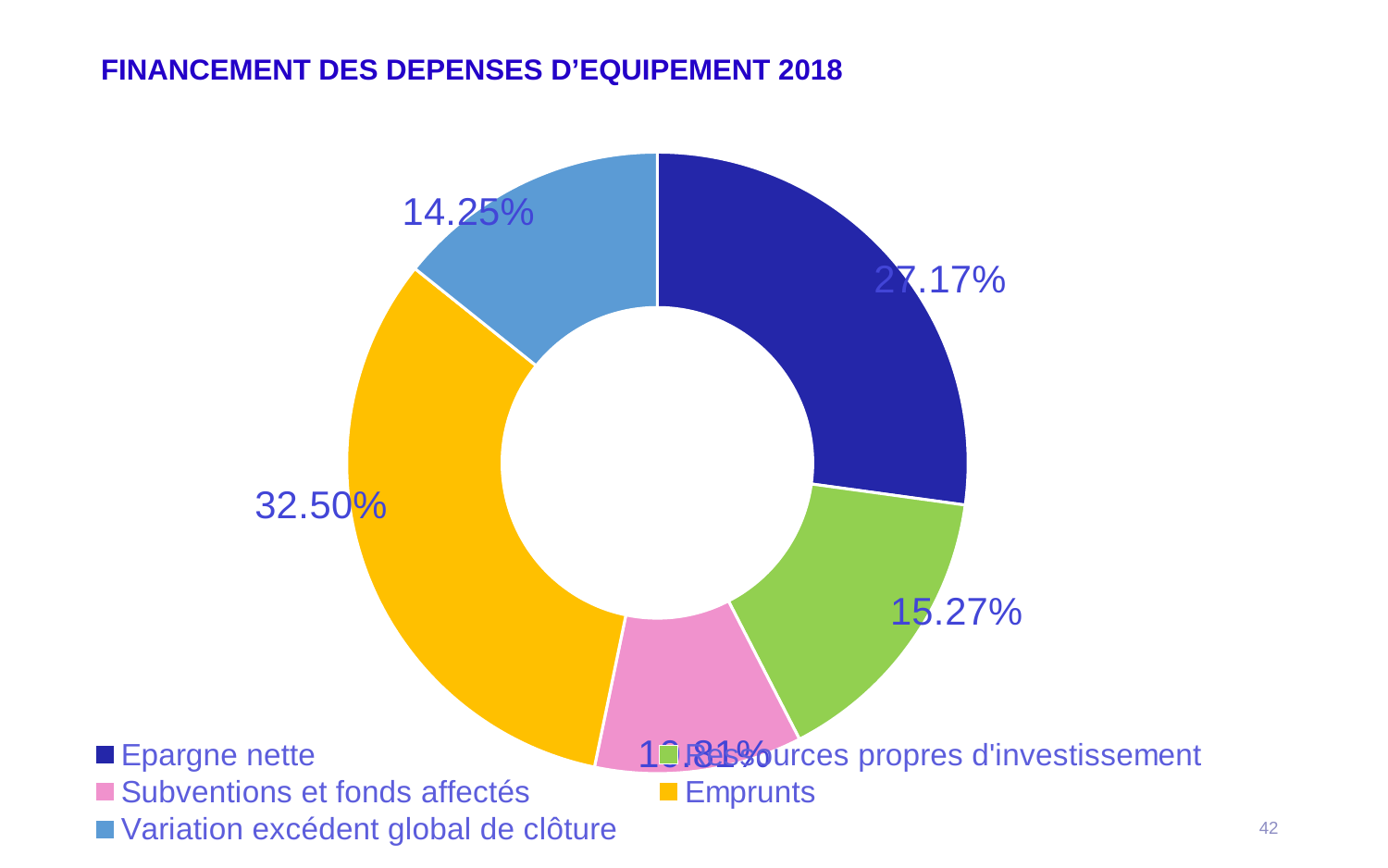
Which is larger, the share for Epargne nette or the share for Ressources propres d'investissement? Epargne nette What share of the financing does Emprunts represent? 32.50% Which category has the smallest share of the chart? Subventions et fonds affectés What percentage is shown for Epargne nette? 27.17% How many percentage points larger is the Emprunts share than the Epargne nette share? 5.33% What is the difference between the Ressources propres d'investissement share and the Variation excédent global de clôture share? 1.02% What is the title of the chart? FINANCEMENT DES DEPENSES D'EQUIPEMENT 2018 What percentage is shown for Ressources propres d'investissement? 15.27% What type of chart is shown on the slide? Doughnut (pie) chart Which category has the largest share of the chart? Emprunts What percentage is shown for Variation excédent global de clôture? 14.25% How many categories are shown in the chart? 5